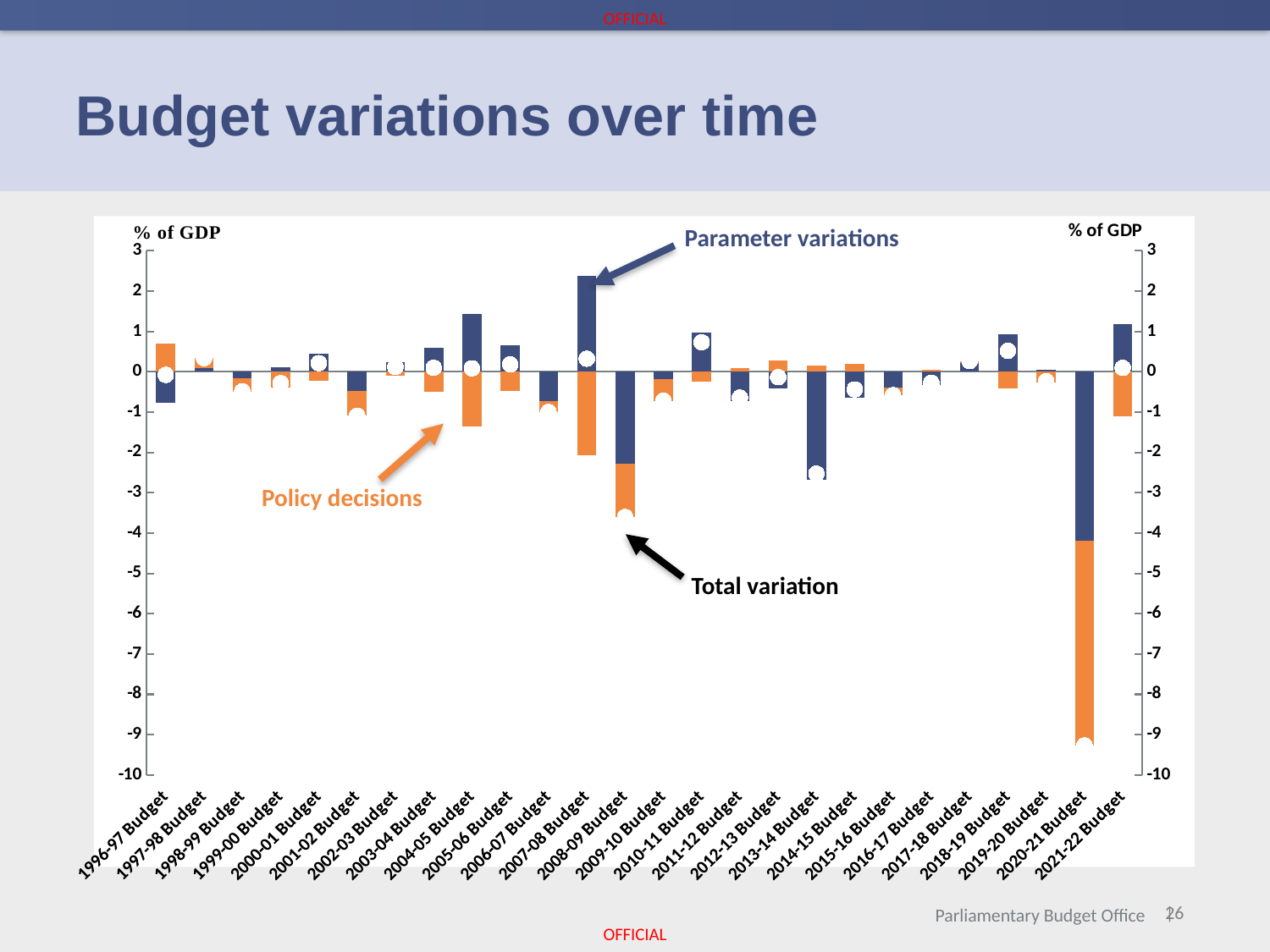
Is the total variation for the 2020-21 Budget greater or less than -9? less Is the parameter variation for the 2013-14 Budget greater or less than -2? less Is the parameter variation for the 2007-08 Budget greater or less than 2? greater Which budget has the largest positive parameter variation? 2007-08 Budget What kind of chart is shown on the slide? Stacked bar chart What colour represents policy decisions on the chart? Orange Which has the larger parameter variation, the 2007-08 Budget or the 2004-05 Budget? 2007-08 Budget How many budgets are shown along the x axis? 26 How many series are labelled on the chart? 3 Which budget has the lowest total variation? 2020-21 Budget Which budget has the largest negative policy decisions value? 2020-21 Budget